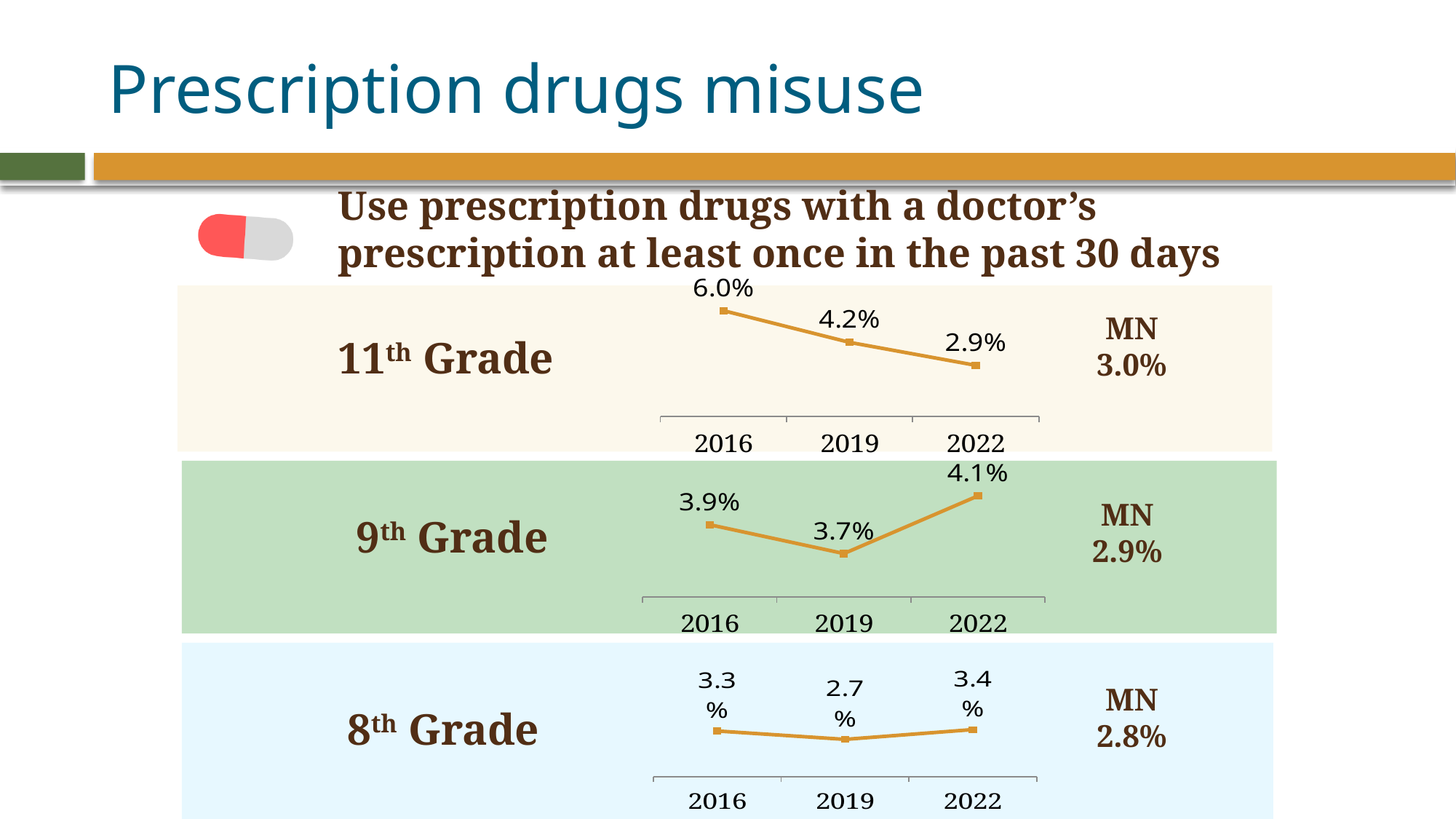
How many data points are plotted in the 8th Grade chart? 3 In the 9th Grade chart, which year has the lowest value? 2019 In the 11th Grade chart, which year has the highest value? 2016 In the 9th Grade chart, which is larger, the value for 2016 or the value for 2022? 2022 In the 11th Grade chart, what is the difference between the 2016 and 2022 values? 3.1% In the 8th Grade chart, what is the value for 2022? 3.4% In the 11th Grade chart, do the values rise or fall from 2016 to 2022? fall In the 11th Grade chart, what is the value for 2016? 6.0% In the 9th Grade chart, what is the value for 2019? 3.7% In the 11th Grade chart, what is the value for 2022? 2.9% In the 8th Grade chart, which year has the lowest value? 2019 What kind of chart is used for the 9th Grade data? line chart